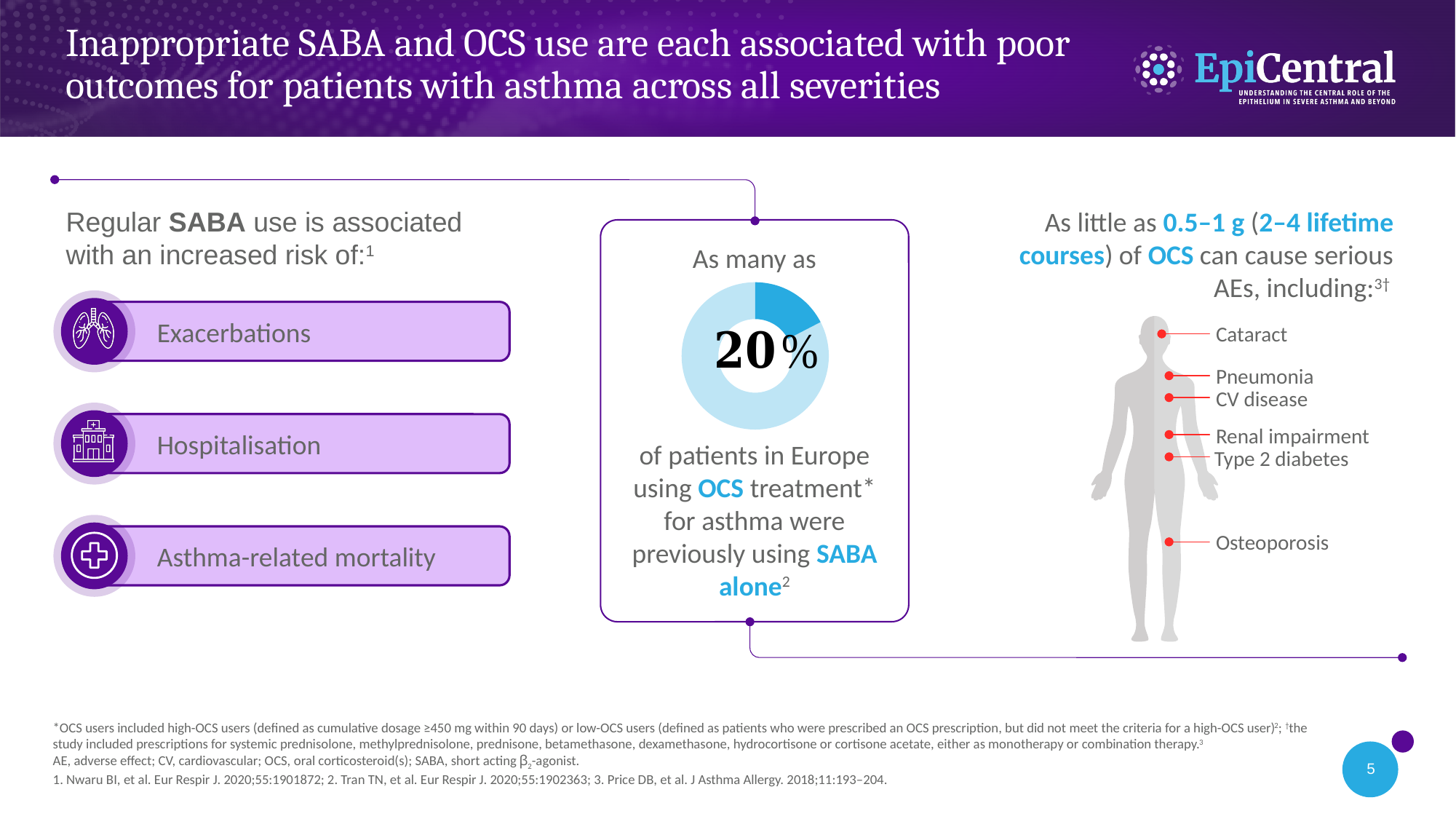
What percentage is shown in the centre of the donut chart? 20% Is the value shown in the donut chart greater or less than 50%? less What text appears directly above the donut chart? As many as What kind of chart is shown in the centre box of the slide? Pie chart (donut) What colour is the highlighted 20% segment of the donut chart? Blue Is the highlighted segment of the donut chart larger or smaller than the remaining segment? smaller How many segments does the donut chart have? 2 According to the donut chart, what share of patients in Europe using OCS treatment for asthma were previously using SABA alone? 20% What share of the donut chart is not covered by the highlighted 20% segment? 80%